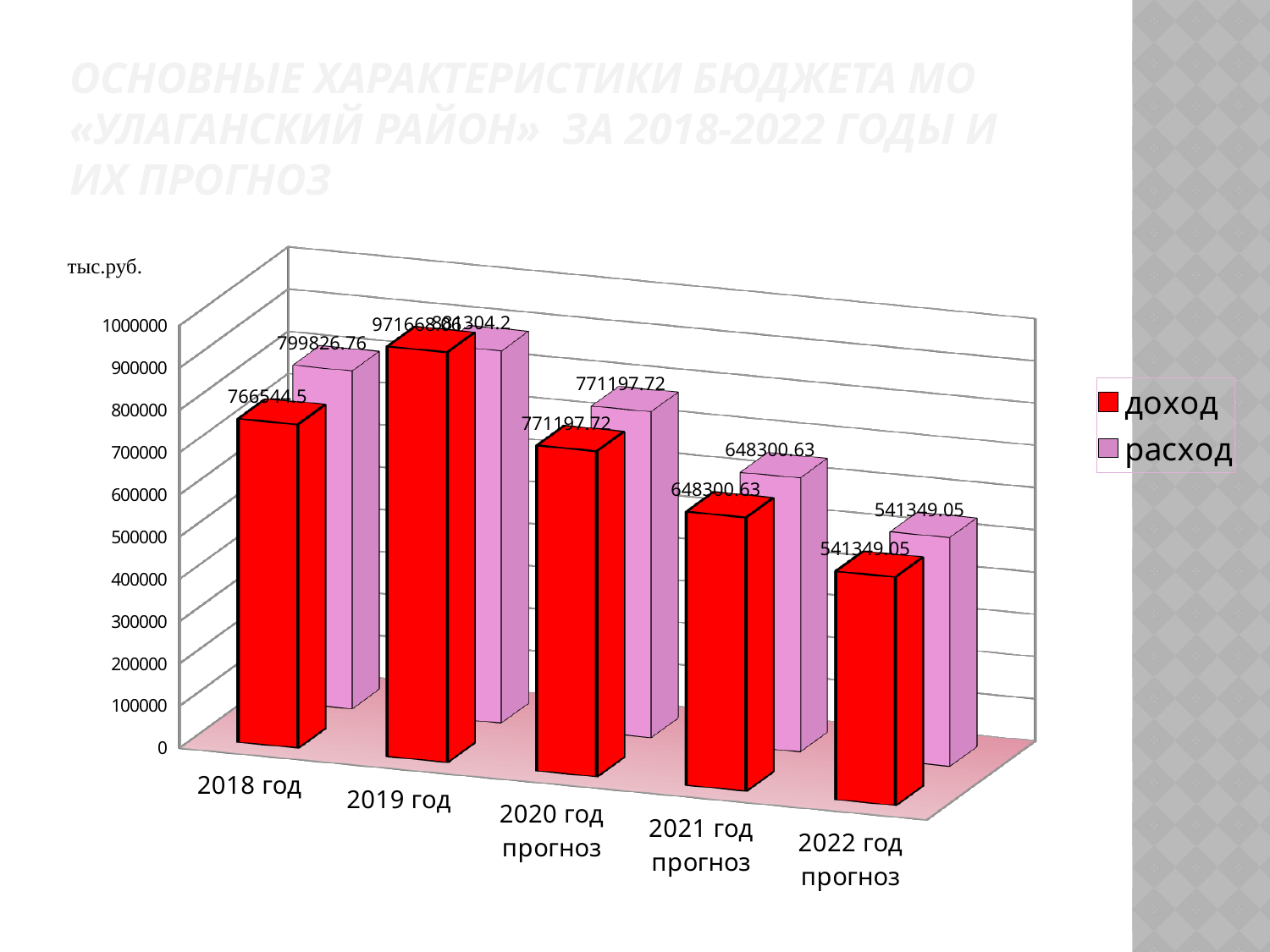
What is the value of расход for 2018 год? 799826.76 In 2018 год, which is larger: доход or расход? расход What is the value of доход for 2020 год прогноз? 771197.72 By how much does расход exceed доход in 2018 год? 33282.26 Which year has the lowest расход? 2022 год прогноз Does доход rise or fall from 2020 год прогноз to 2022 год прогноз? falls What is the value of доход for 2018 год? 766544.5 What is the value of доход for 2022 год прогноз? 541349.05 How many years (categories) are shown on the x axis? 5 Which year has the highest доход? 2019 год How many series does the legend list? 2 What is the value of расход for 2021 год прогноз? 648300.63